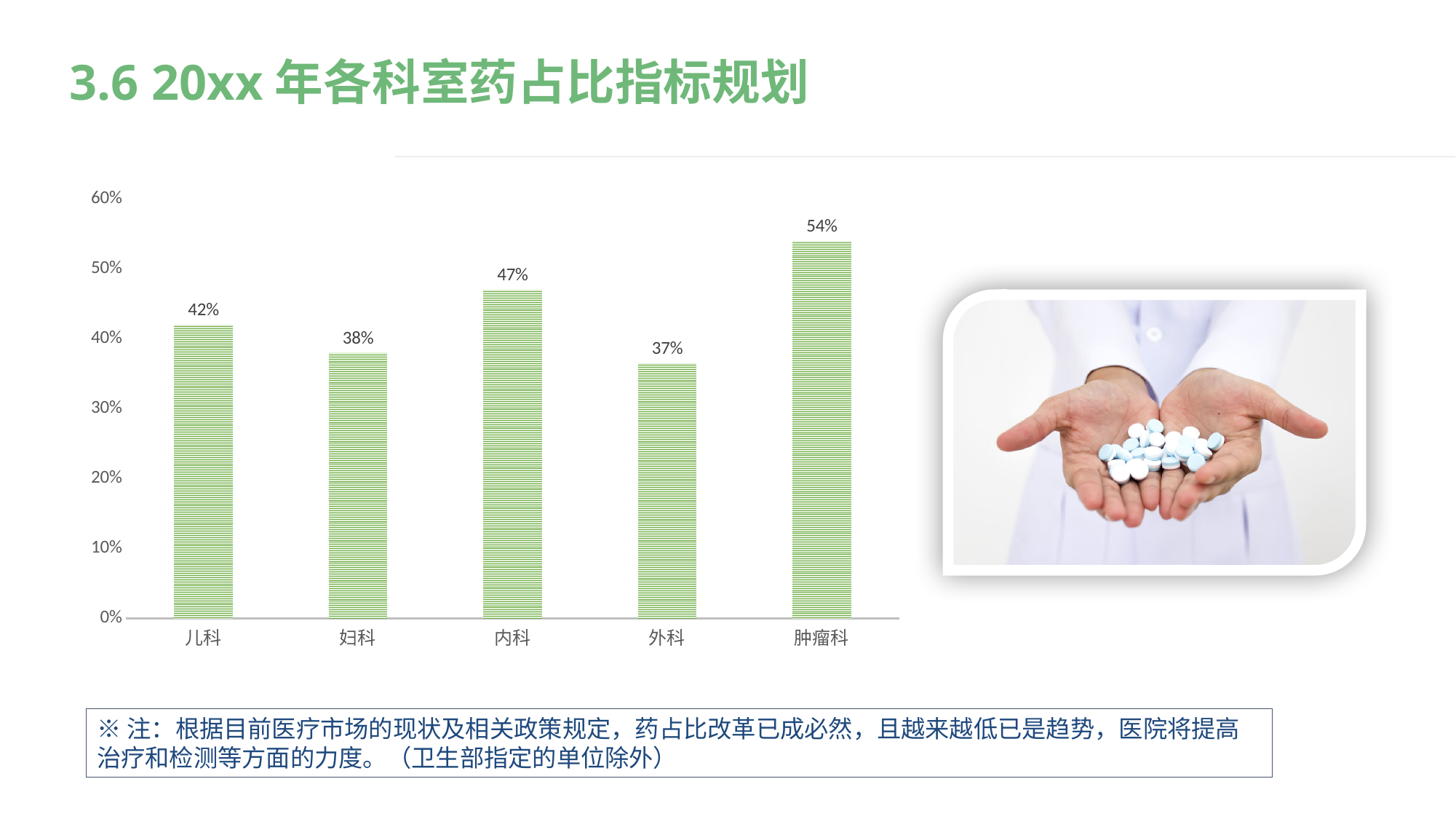
How many departments are shown on the x axis? 5 Which department has the lowest value? 外科 What is the value for 肿瘤科? 54% What is the difference between the values for 肿瘤科 and 外科? 17% Is the value for 肿瘤科 greater or less than 50%? greater What is the value for 儿科? 42% Which is larger, the value for 内科 or the value for 儿科? 内科 What is the value for 外科? 37% What is the value for 内科? 47% What kind of chart is shown on the slide? bar chart What is the value for 妇科? 38% Which department has the highest value? 肿瘤科